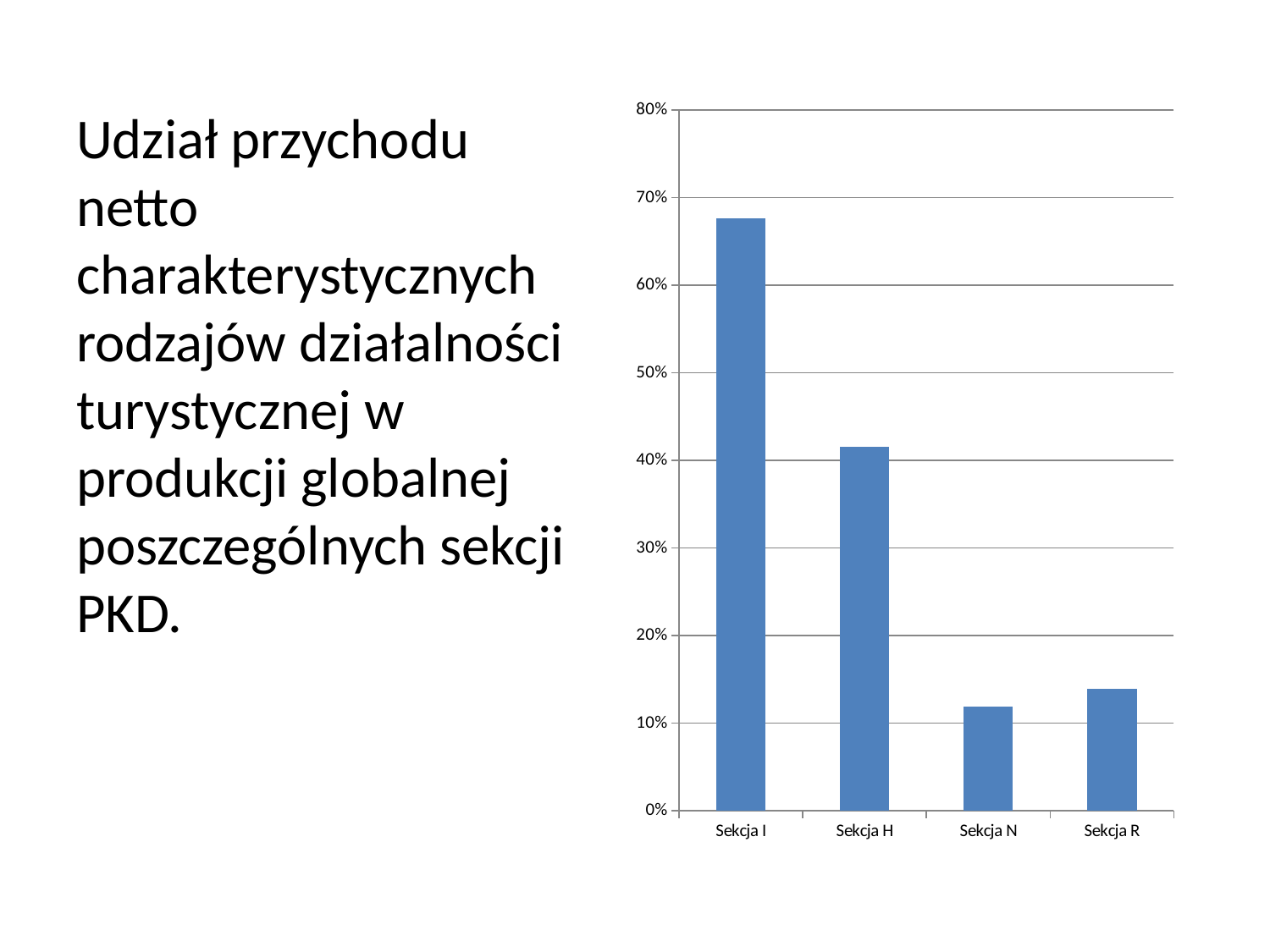
What is the label of the first category on the horizontal axis? Sekcja I How many categories (sections) are shown on the chart? 4 Is the value for Sekcja R greater or less than 10%? greater Is the value for Sekcja H greater or less than 40%? greater Is the value for Sekcja I greater or less than 60%? greater What kind of chart is shown on the slide? bar chart What is the highest value shown on the vertical axis of the chart? 80% Which section has the highest value on the chart? Sekcja I Which is larger, the value for Sekcja H or the value for Sekcja N? Sekcja H